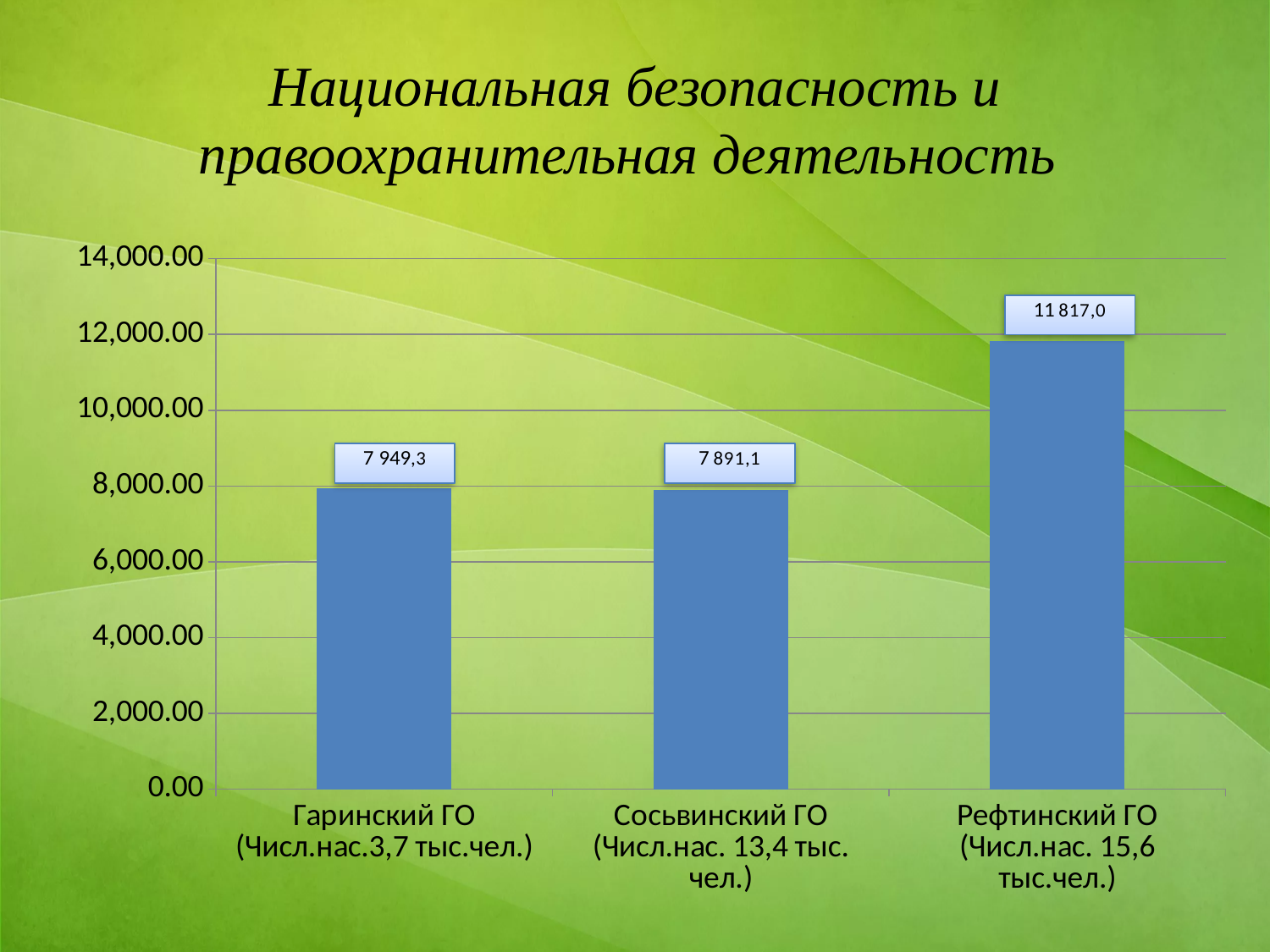
What is the value for Сосьвинский ГО? 7 891,1 Which category has the lowest value? Сосьвинский ГО What is the difference between the values for Рефтинский ГО and Сосьвинский ГО? 3 925,9 What is the value for Рефтинский ГО? 11 817,0 Is the value for Сосьвинский ГО greater or less than 10,000.00? less What is the difference between the values for Рефтинский ГО and Гаринский ГО? 3 867,7 How many categories are shown in the chart? 3 Which category has the highest value? Рефтинский ГО What kind of chart is shown on the slide? bar chart Is the value for Рефтинский ГО greater or less than 10,000.00? greater Which is larger, the value for Рефтинский ГО or the value for Гаринский ГО? Рефтинский ГО What is the value for Гаринский ГО? 7 949,3